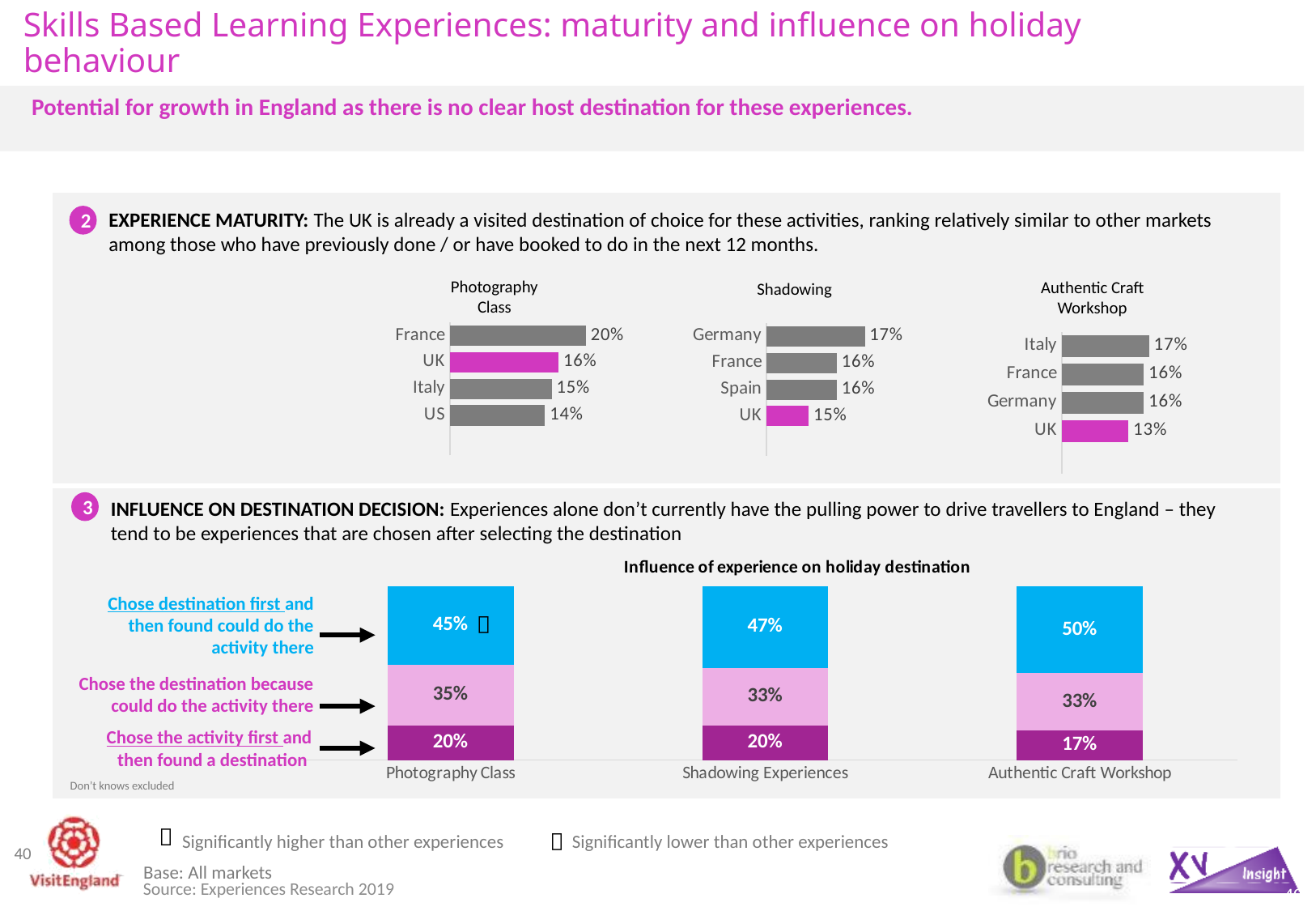
What kind of chart is the Influence of experience on holiday destination chart? Stacked bar chart In the Photography Class chart, which is larger, the value for the UK or the value for Italy? UK In the Shadowing chart, which country has the highest value? Germany In the Photography Class chart, how many countries are shown? 4 In the Authentic Craft Workshop chart, what is the difference between Italy and the UK? 4% In the Influence of experience on holiday destination chart, what share of Authentic Craft Workshop respondents chose the destination first and then found they could do the activity there? 50% In the Photography Class chart, which country has the lowest value? US In the Authentic Craft Workshop chart, what is the value for Italy? 17% In the Influence of experience on holiday destination chart, what share of Photography Class respondents chose the activity first and then found a destination? 20% In the Photography Class chart, what is the value for France? 20% In the Shadowing chart, what is the value for the UK? 15% In the Influence of experience on holiday destination chart, how many experience categories are shown on the x axis? 3